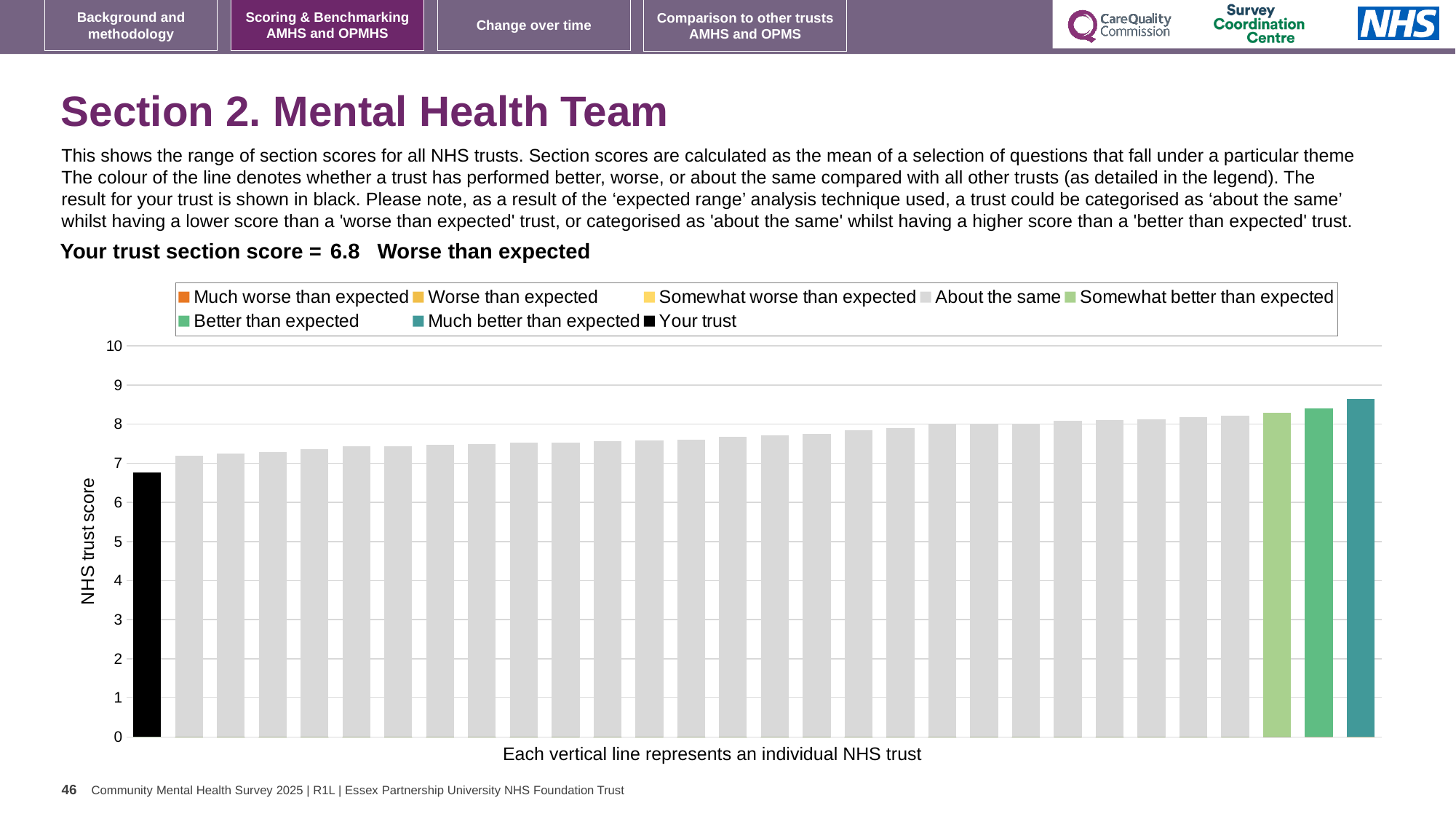
Which bar is the lowest on the chart? Your trust (the black bar) What kind of chart is shown on the slide? bar chart How many entries does the legend list? 8 What does each vertical line on the chart represent, according to the x-axis caption? An individual NHS trust How is your trust's section score categorised compared with other trusts? Worse than expected Is the value for the black 'Your trust' bar greater or less than 7? less Which category does the highest bar belong to? Much better than expected What is the section score for your trust? 6.8 What is the label on the y axis? NHS trust score How many bars are coloured black? 1 Is the value for the tallest bar (Much better than expected) greater or less than 8? greater Do the bar values rise or fall from left to right along the x axis? rise